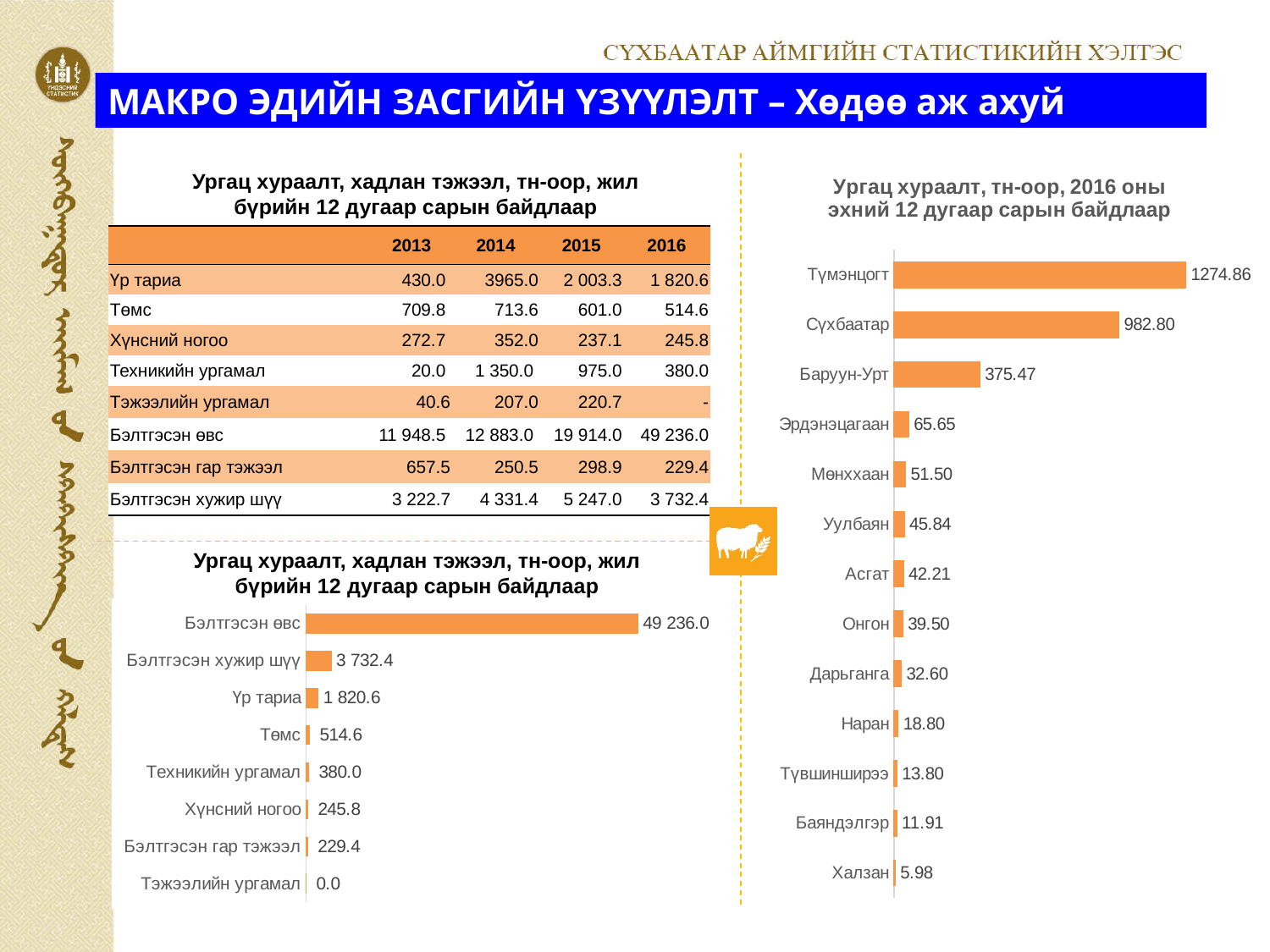
What type of chart is the chart on the right of the slide? Bar chart In the chart on the right, which category has the highest value? Түмэнцогт In the bottom-left chart, what is the value for Төмс? 514.6 In the bottom-left chart, which category has the lowest value? Тэжээлийн ургамал In the chart on the right, which category has the lowest value? Халзан In the chart on the right, how many categories are shown? 13 In the chart on the right, what is the difference between the values for Түмэнцогт and Сүхбаатар? 292.06 In the bottom-left chart, how many categories are shown? 8 In the bottom-left chart titled "Ургац хураалт, хадлан тэжээл, тн-оор, жил бүрийн 12 дугаар сарын байдлаар", what is the value for Бэлтгэсэн өвс? 49 236.0 In the chart on the right titled "Ургац хураалт, тн-оор, 2016 оны эхний 12 дугаар сарын байдлаар", what is the value for Түмэнцогт? 1274.86 In the chart on the right, what is the value for Баруун-Урт? 375.47 In the chart on the right, which is larger, the value for Эрдэнэцагаан or the value for Мөнххаан? Эрдэнэцагаан